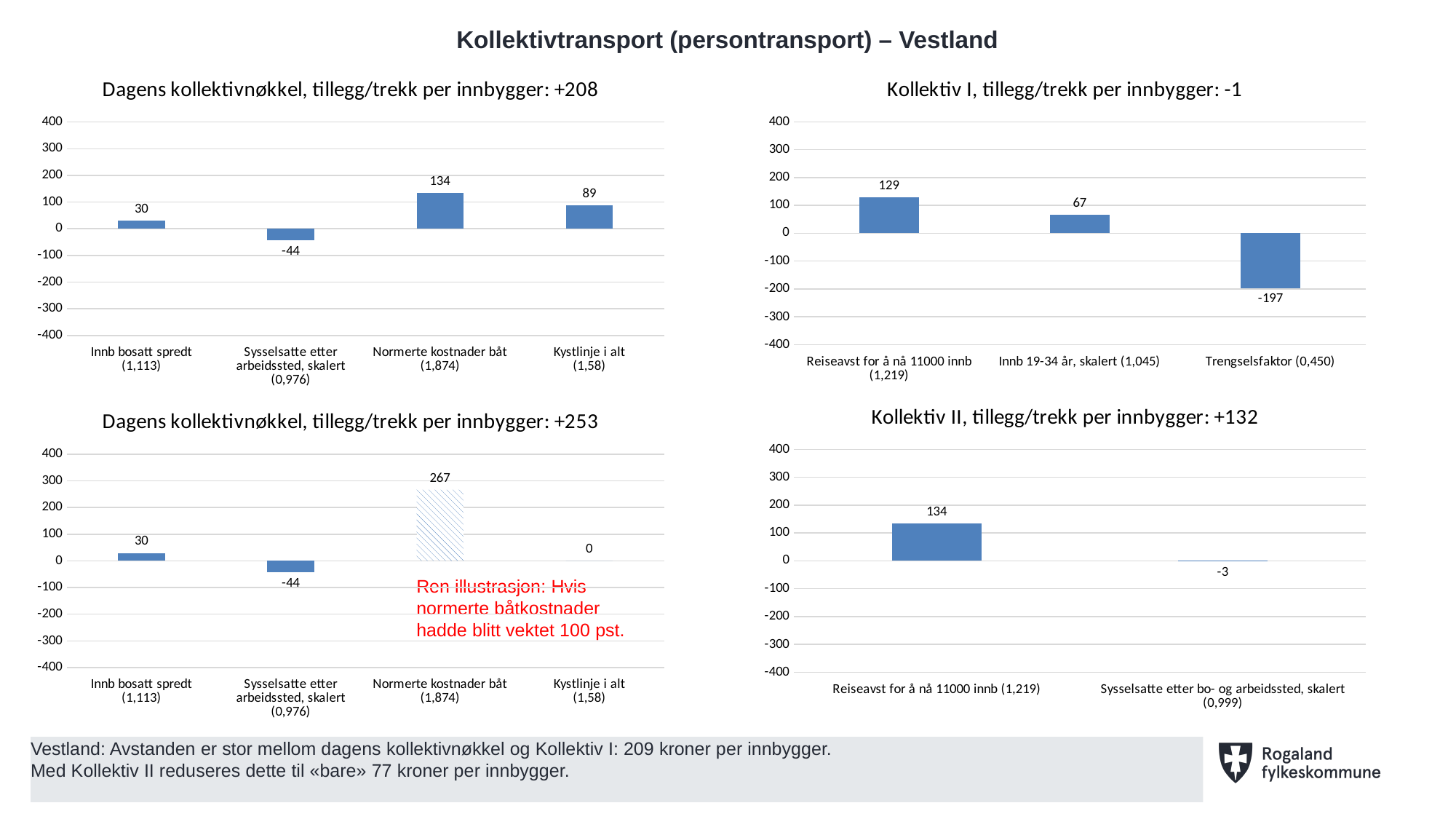
In the top-left chart (Dagens kollektivnøkkel, +208), which category has the lowest value? Sysselsatte etter arbeidssted, skalert (0,976) In the top-right chart (Kollektiv I, -1), what is the value for Trengselsfaktor (0,450)? -197 In the top-left chart (Dagens kollektivnøkkel, +208), what is the value for Normerte kostnader båt (1,874)? 134 In the bottom-right chart (Kollektiv II, +132), what is the value for Sysselsatte etter bo- og arbeidssted, skalert (0,999)? -3 In the top-right chart (Kollektiv I, -1), which category has the highest value? Reiseavst for å nå 11000 innb (1,219) What type of chart is the top-right chart (Kollektiv I, -1)? Bar chart In the top-left chart (Dagens kollektivnøkkel, +208), what is the difference between Normerte kostnader båt (1,874) and Kystlinje i alt (1,58)? 45 How many charts are shown on the slide? 4 How many categories are shown in the top-right chart (Kollektiv I, -1)? 3 In the bottom-right chart (Kollektiv II, +132), which is larger: Reiseavst for å nå 11000 innb (1,219) or Sysselsatte etter bo- og arbeidssted, skalert (0,999)? Reiseavst for å nå 11000 innb (1,219) In the bottom-left chart (Dagens kollektivnøkkel, +253), what is the value for Normerte kostnader båt (1,874)? 267 In the bottom-left chart (Dagens kollektivnøkkel, +253), what is the value for Kystlinje i alt (1,58)? 0